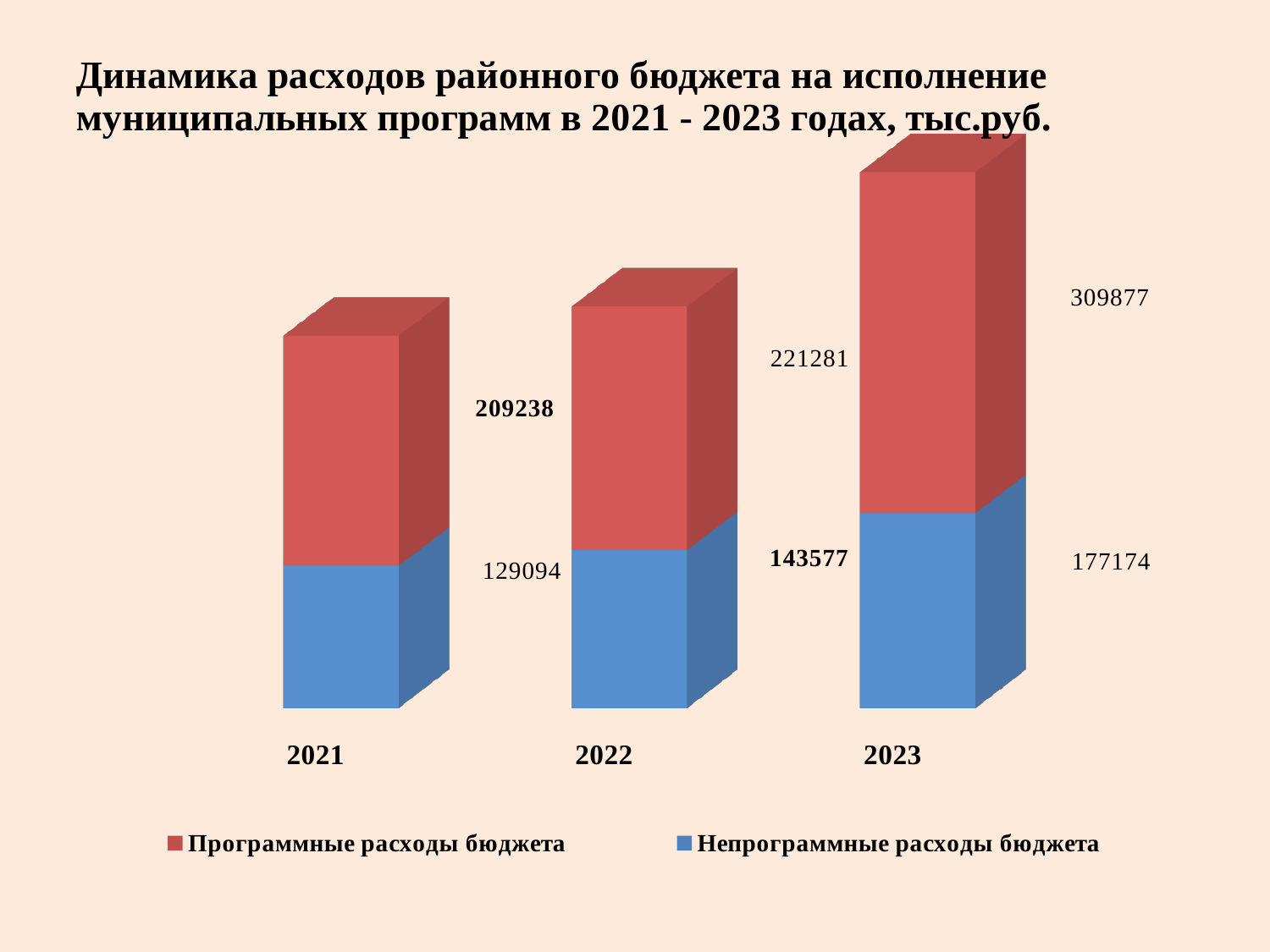
In which year is Программные расходы бюджета the highest? 2023 How many series does the legend list? 2 What is the total of the stacked bar for 2021? 338332 What is the difference between Программные расходы бюджета in 2023 and in 2022? 88596 What type of chart is shown on the slide? Stacked bar chart How many years (categories) are shown on the x axis? 3 What is the value of Программные расходы бюджета in 2023? 309877 What is the value of Непрограммные расходы бюджета in 2023? 177174 What is the value of Непрограммные расходы бюджета in 2022? 143577 What is the value of Программные расходы бюджета in 2021? 209238 Do the values of Программные расходы бюджета rise or fall from 2021 to 2023? Rise In which year is Непрограммные расходы бюджета the lowest? 2021